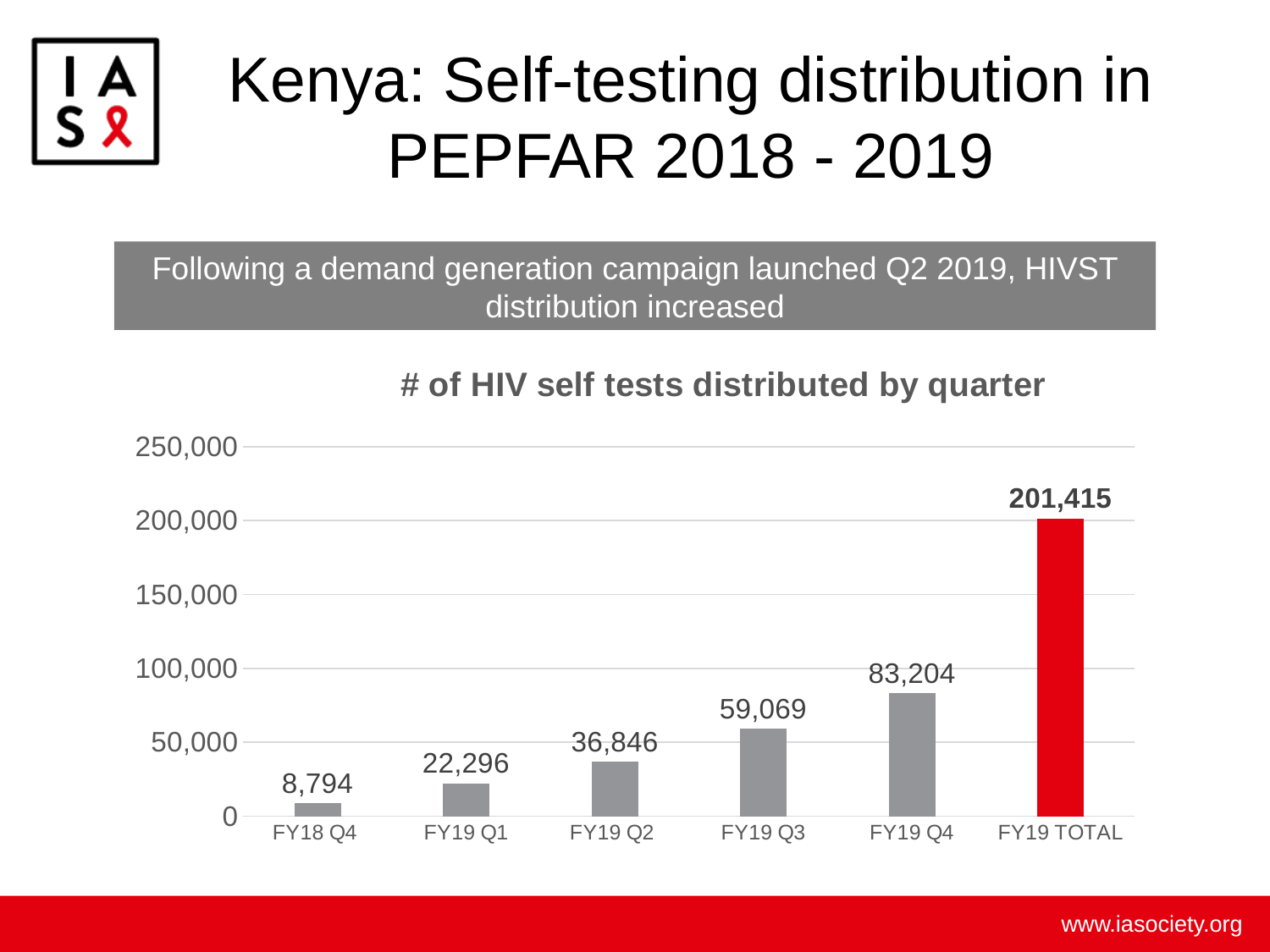
What is the value shown for FY19 TOTAL? 201,415 Which quarter (excluding the FY19 TOTAL bar) has the highest number of HIV self tests distributed? FY19 Q4 Which category has the lowest value on the chart? FY18 Q4 What is the value shown for FY18 Q4? 8,794 What is the difference between the FY19 Q4 and FY19 Q3 values? 24,135 Do the quarterly values rise or fall from FY18 Q4 to FY19 Q4? rise Which is larger, the value for FY19 Q2 or the value for FY19 Q1? FY19 Q2 How many bars are shown on the chart? 6 What kind of chart is shown on the slide? bar chart Is the value for FY19 Q4 greater or less than 100,000? less How many HIV self tests were distributed in FY19 Q3? 59,069 What is the title of the chart? # of HIV self tests distributed by quarter